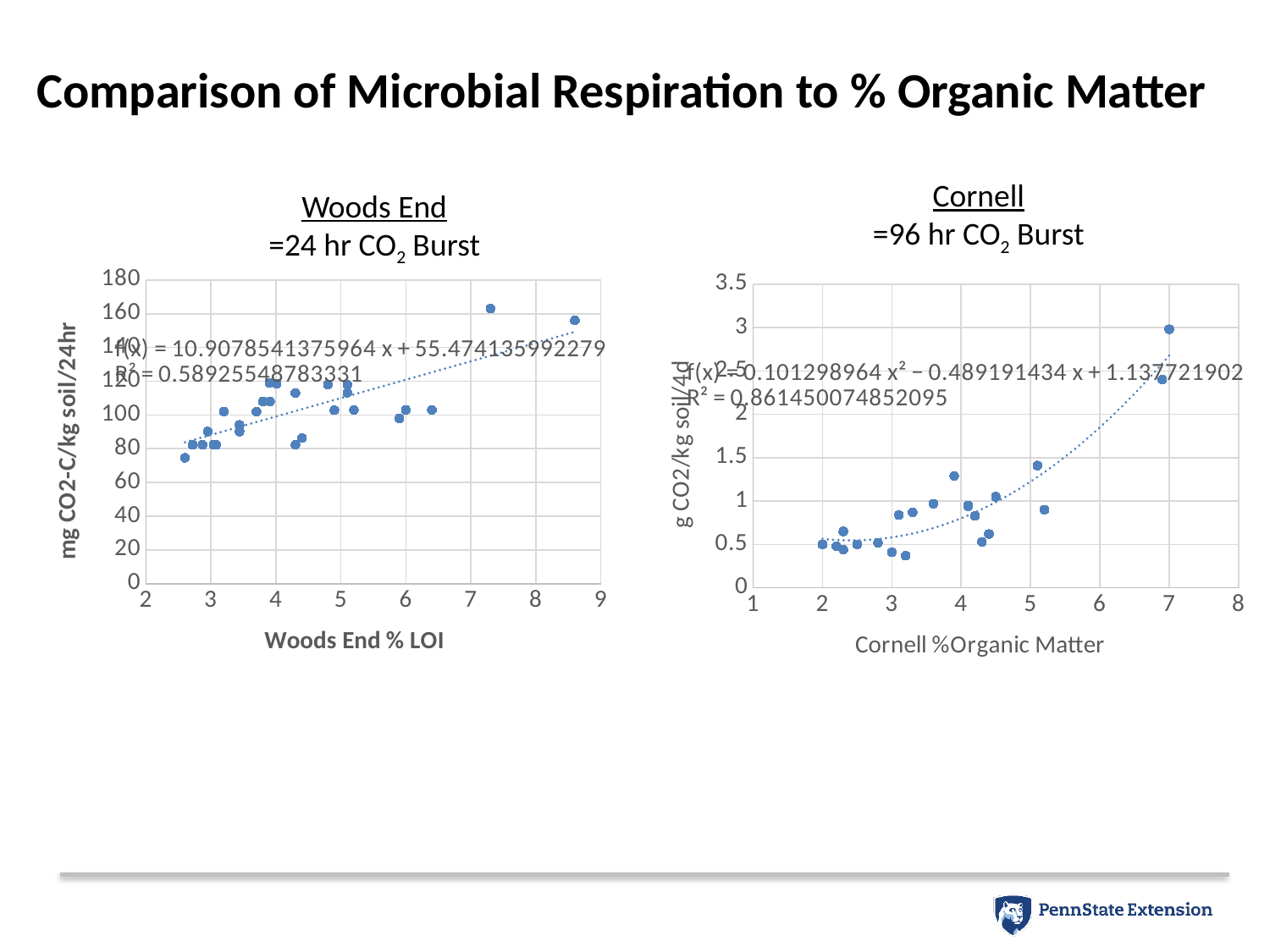
What R² value is printed on the Woods End chart? 0.58925548783331 In the Cornell chart, do the values generally rise or fall as Cornell % Organic Matter increases? rise What kind of chart is the Woods End chart on the left? scatter chart What kind of chart is the Cornell chart on the right? scatter chart What is the x-axis title of the Woods End chart? Woods End % LOI In the Cornell chart, is the highest plotted value greater or less than 2.5? greater What is the y-axis title of the Cornell chart? g CO2/kg soil/4d In the Woods End chart, is the lowest plotted value greater or less than 80? less Which chart shows the higher R² value, Woods End or Cornell? Cornell What is the slope coefficient in the trendline equation printed on the Woods End chart? 10.9078541375964 In the Woods End chart, do the respiration values generally rise or fall as Woods End % LOI increases? rise What R² value is printed on the Cornell chart? 0.861450074852095